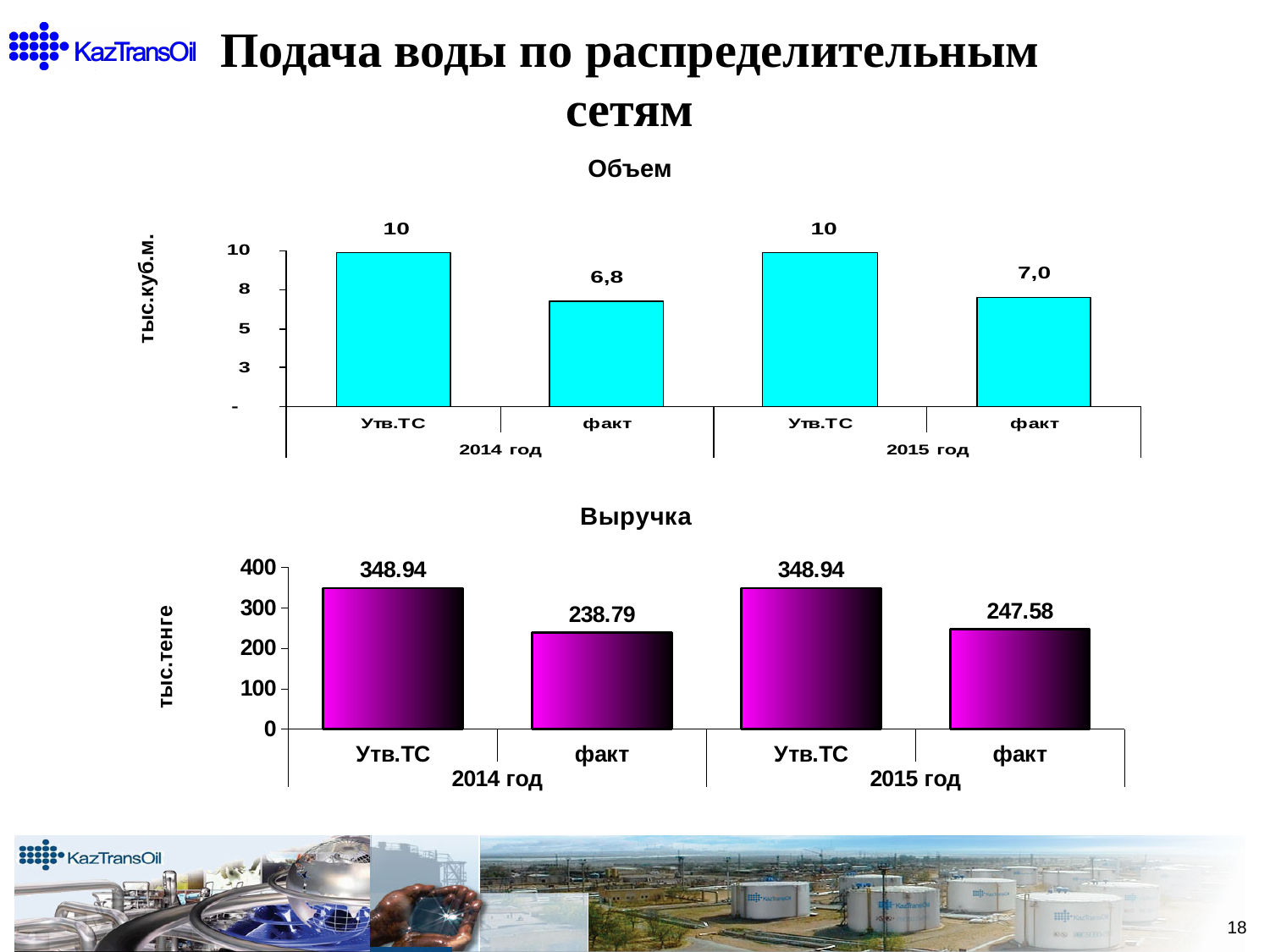
In the "Объем" chart, what is the value for факт in 2014 год? 6,8 In the "Объем" chart, what is the value for факт in 2015 год? 7,0 How many bars are plotted in the "Объем" chart? 4 In the "Объем" chart, which is larger: факт in 2014 год or факт in 2015 год? факт in 2015 год In the "Объем" chart, what is the value for Утв.ТС in 2015 год? 10 In the "Выручка" chart, is the value for факт in 2015 год greater or less than 300? less What is the y-axis unit label of the "Выручка" chart? тыс.тенге In the "Выручка" chart, which bar has the lowest value? факт, 2014 год In the "Выручка" chart, what is the difference between Утв.ТС and факт in 2015 год? 101.36 In the "Выручка" chart, what is the value for факт in 2014 год? 238.79 In the "Выручка" chart, what is the value for Утв.ТС in 2015 год? 348.94 What kind of chart is the "Выручка" chart? bar chart